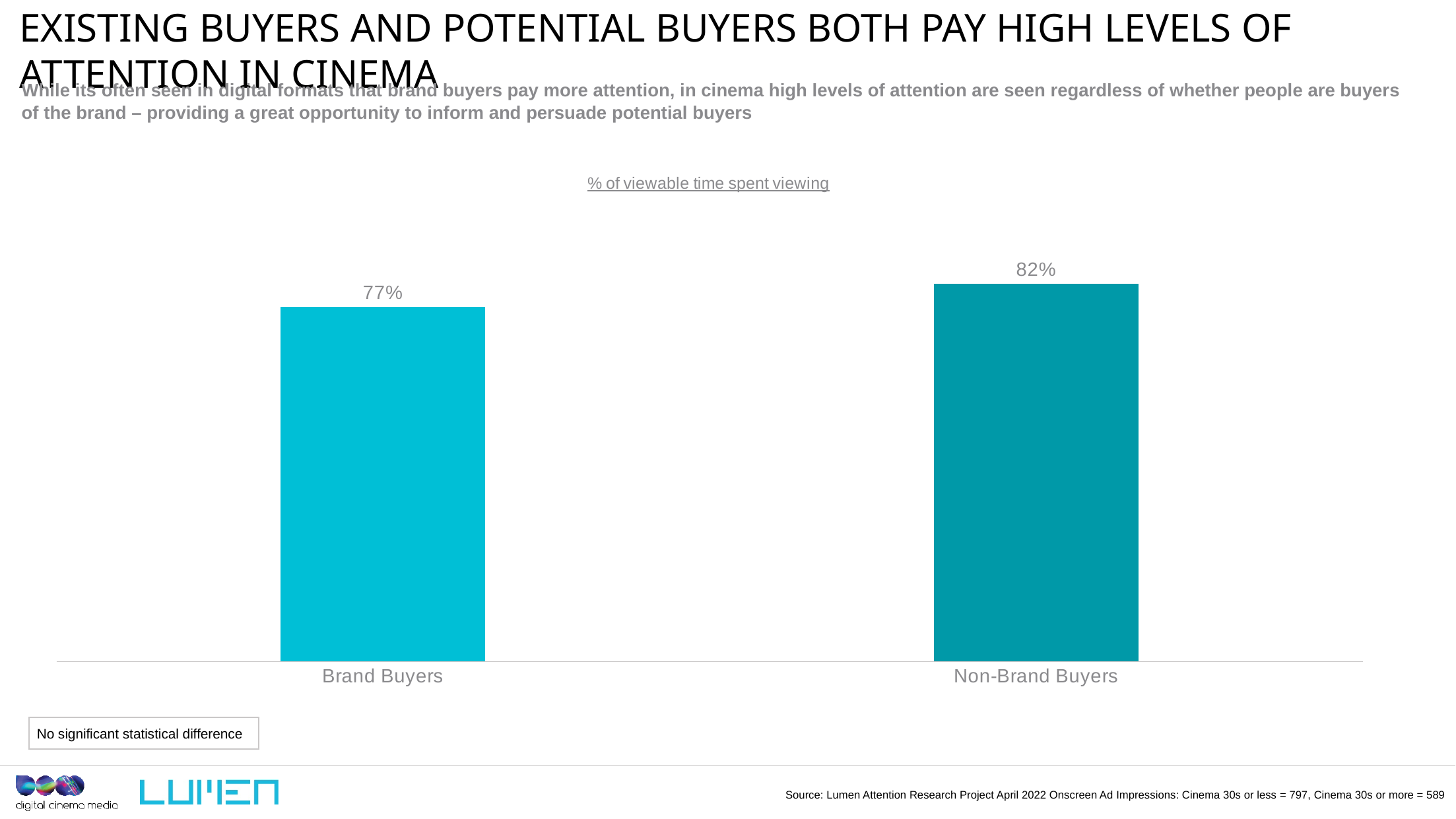
Which category has the lowest value? Brand Buyers How many categories are shown in the chart? 2 What is the title of the chart? % of viewable time spent viewing What does the note in the box below the chart say? No significant statistical difference Which is larger, the value for Brand Buyers or the value for Non-Brand Buyers? Non-Brand Buyers What is the difference between the values for Non-Brand Buyers and Brand Buyers? 5% What is the value for Brand Buyers? 77% What kind of chart is shown on the slide? Bar chart Which category has the highest value? Non-Brand Buyers What is the value for Non-Brand Buyers? 82%